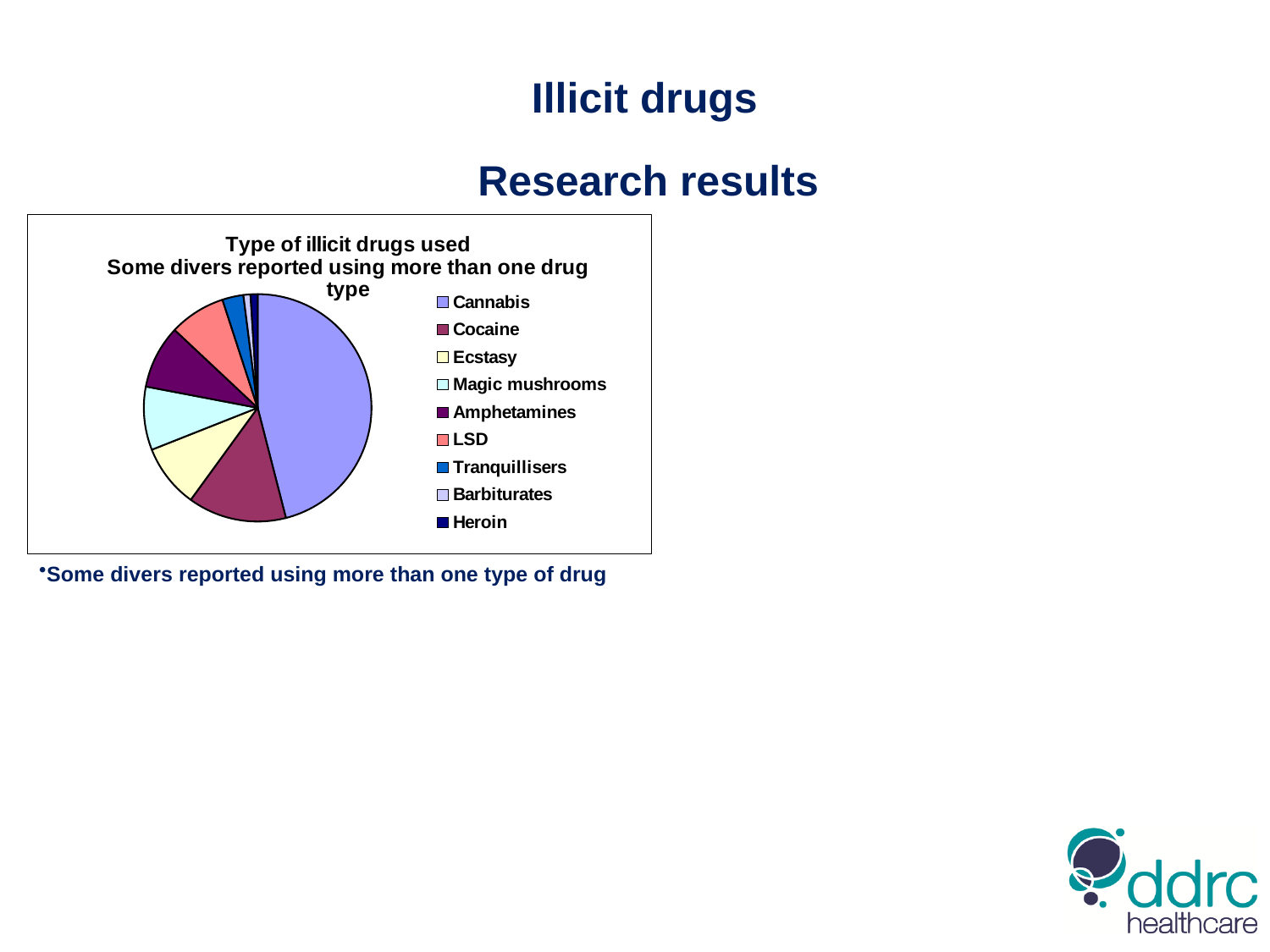
Which slice is larger, Cocaine or Ecstasy? Cocaine Which slice is larger, LSD or Tranquillisers? LSD What kind of chart is shown on the slide? Pie chart Which slice is larger, Magic mushrooms or Barbiturates? Magic mushrooms Which drug type has the largest slice of the pie chart? Cannabis Which drug type is listed last in the pie chart's legend? Heroin How many categories does the pie chart's legend list? 9 Which drug type is listed first in the pie chart's legend? Cannabis